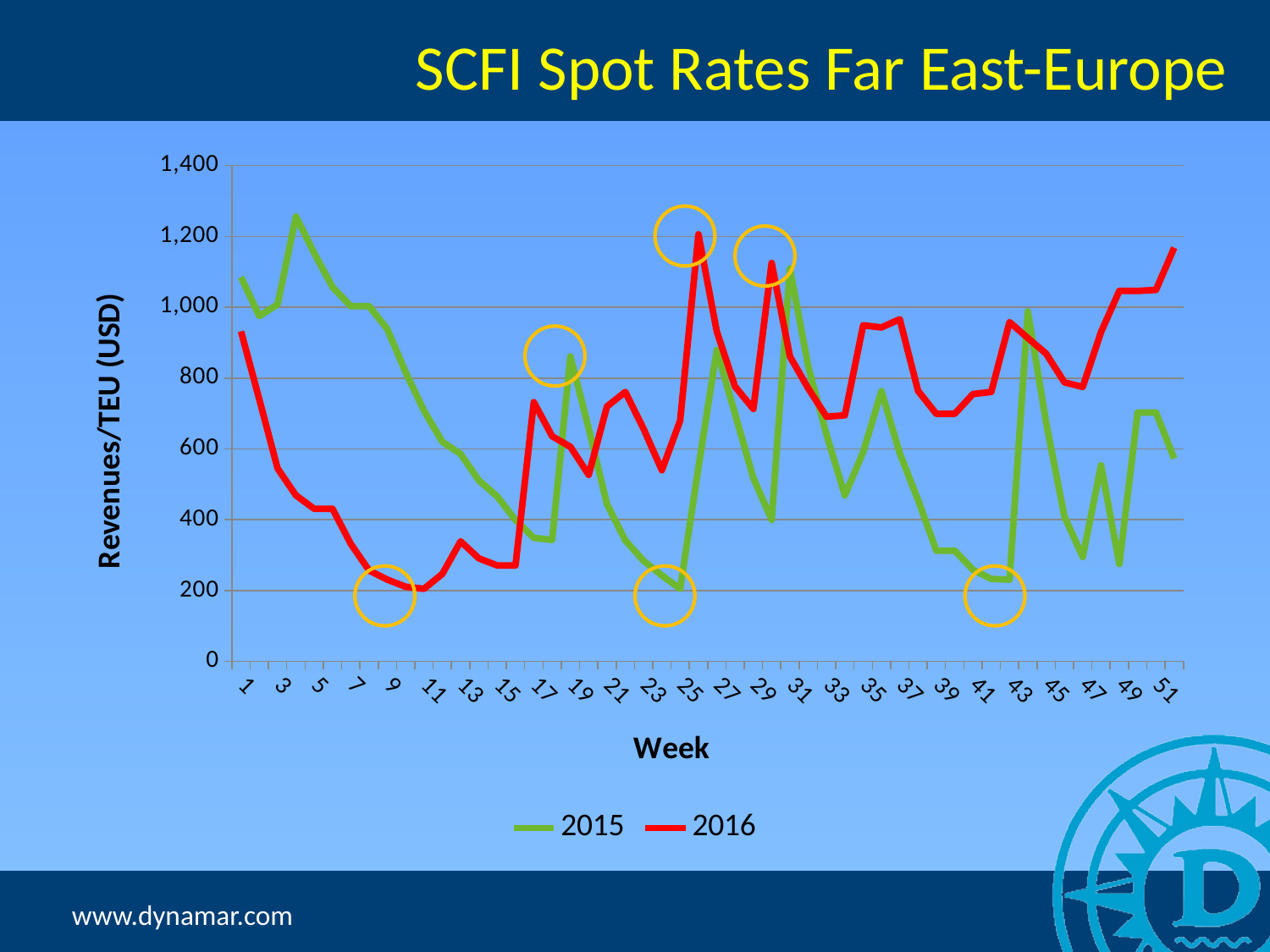
What is the label on the vertical axis? Revenues/TEU (USD) At week 9, which series has the higher value, 2015 or 2016? 2015 What is the title of the chart? SCFI Spot Rates Far East-Europe At week 51, which series has the higher value, 2015 or 2016? 2016 Is the 2015 value at week 42 greater or less than 400? less Does the 2016 line rise or fall from week 1 to week 9? fall Is the 2016 value at week 1 greater or less than 800? greater What kind of chart is shown on the slide? Line chart Is the 2016 value at week 51 greater or less than 1,000? greater How many series does the legend list? 2